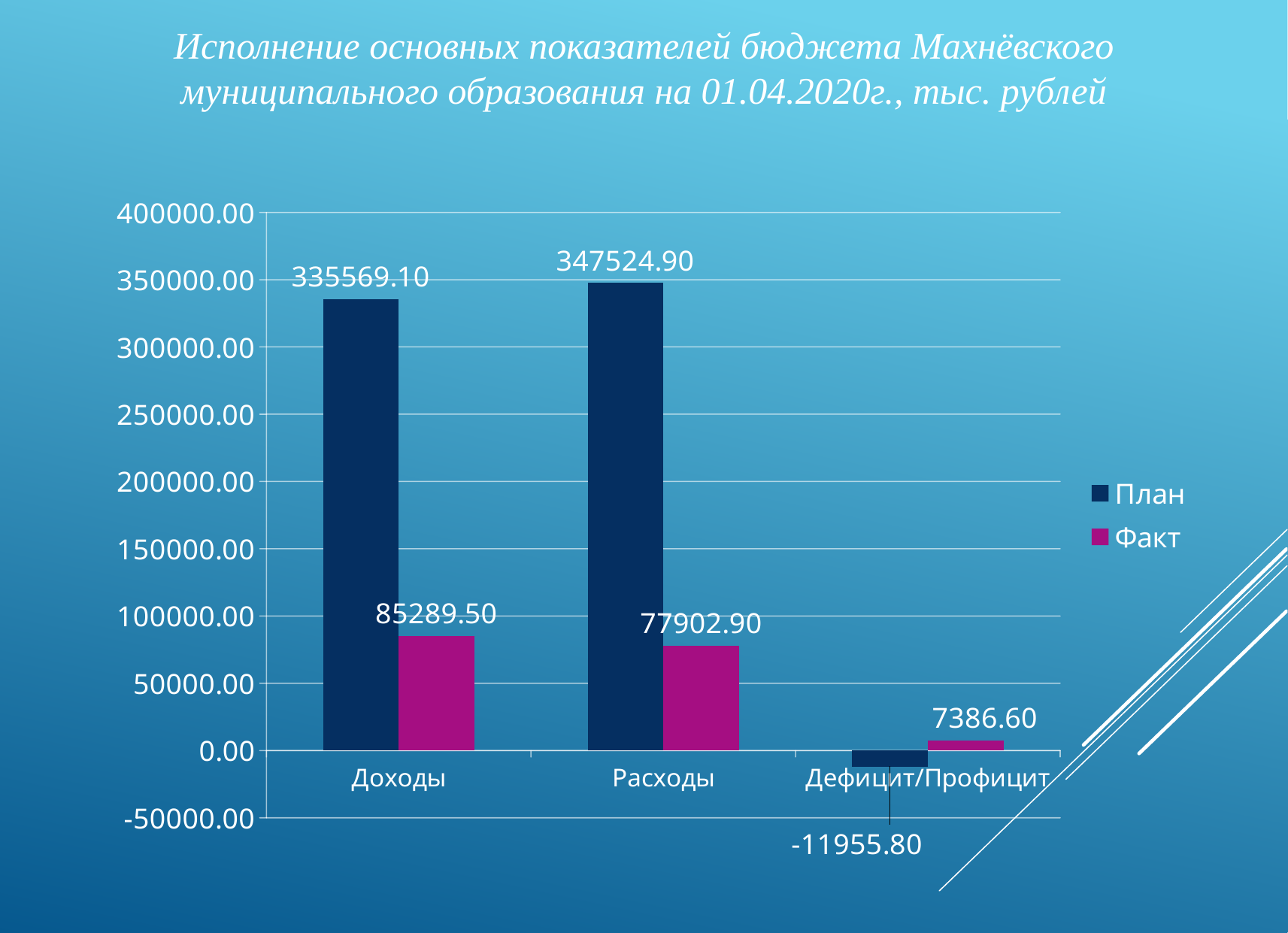
Which category has the lowest Факт value? Дефицит/Профицит What is the План value for Дефицит/Профицит? -11955.80 What is the Факт value for Дефицит/Профицит? 7386.60 What kind of chart is shown on the slide? Bar chart What is the План value for Доходы? 335569.10 What is the Факт value for Расходы? 77902.90 How many series does the legend list? 2 Which is larger, the Факт value for Доходы or the Факт value for Расходы? Доходы How many categories are shown on the x axis? 3 What is the difference between the Факт values for Доходы and Расходы? 7386.60 What is the difference between the План values for Расходы and Доходы? 11955.80 Which category has the highest План value? Расходы